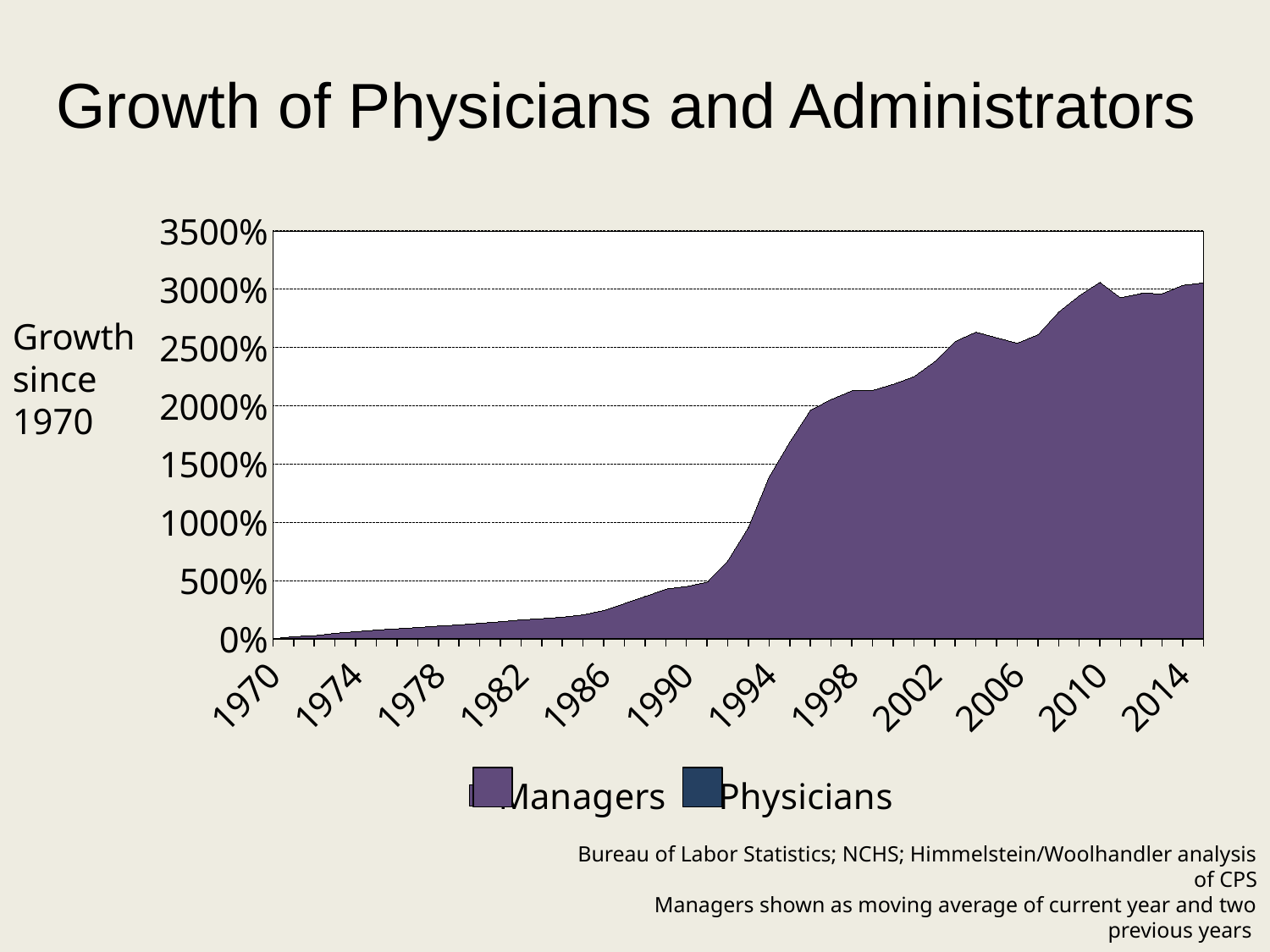
Is the value for Managers in 1982 greater or less than 500%? less How many series does the legend list? 2 Does the Managers series generally rise or fall from 1970 to 2014? rise Which is larger for Managers: the value in 1994 or the value in 2006? 2006 In which year is the Managers series at its lowest? 1970 What are the two series named in the legend? Managers and Physicians Is the value for Managers in 2014 greater or less than 2500%? greater Is the value for Managers in 1990 greater or less than 1000%? less What kind of chart is shown on the slide? area chart What is the title of the chart? Growth of Physicians and Administrators How many year labels are shown on the x axis? 12